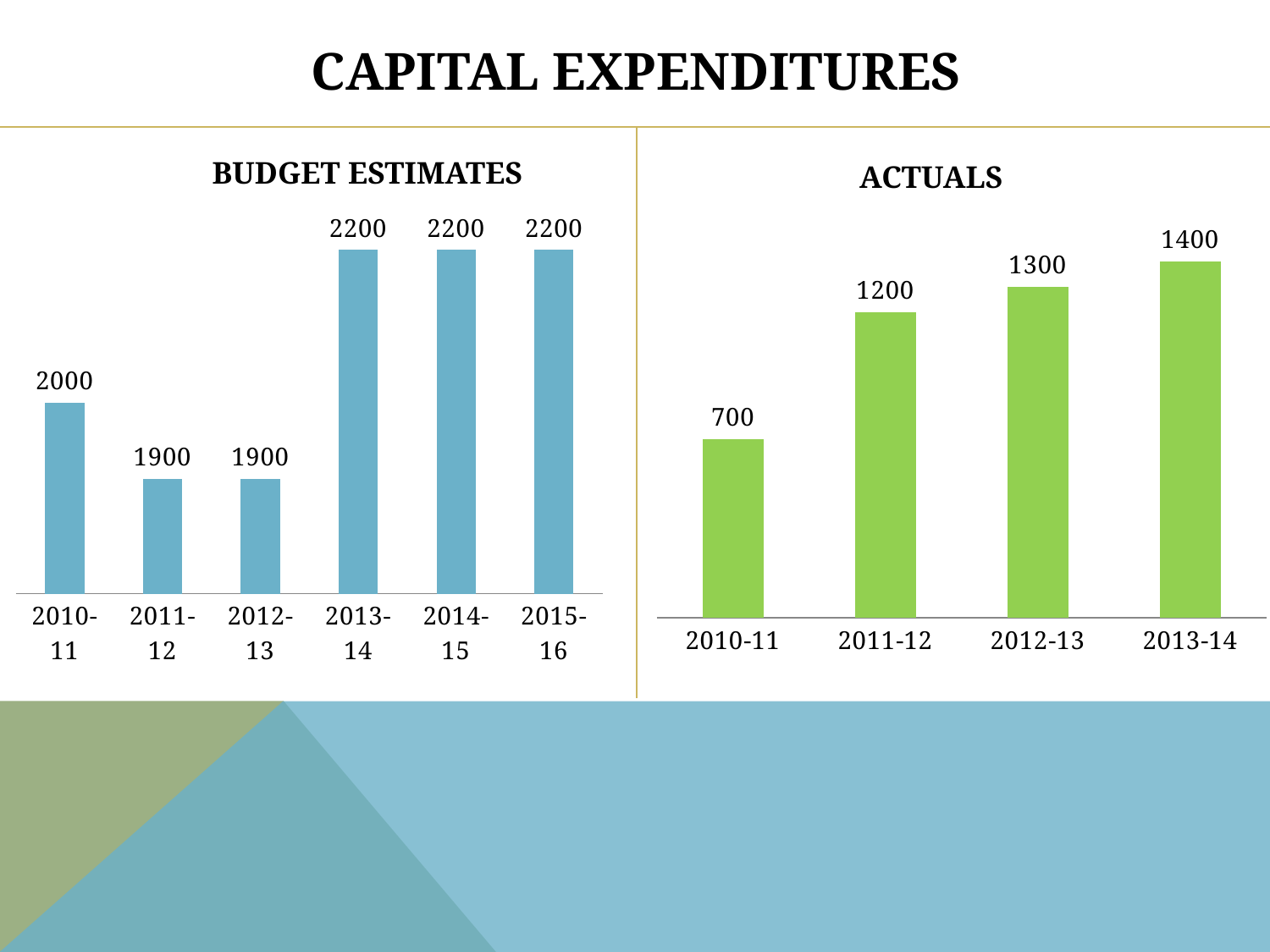
In the Actuals chart, what is the value for 2011-12? 1200 How many years are shown in the Budget Estimates chart? 6 In the Actuals chart, which year has the lowest value? 2010-11 How many years are shown in the Actuals chart? 4 In the Budget Estimates chart, what is the value for 2010-11? 2000 In the Actuals chart, what is the difference between the values for 2013-14 and 2010-11? 700 What kind of chart is the Actuals chart? bar chart In the Actuals chart, do the values rise or fall from 2010-11 to 2013-14? rise In the Actuals chart, which year has the highest value? 2013-14 In the Budget Estimates chart, which is larger, the value for 2010-11 or the value for 2011-12? 2010-11 In the Budget Estimates chart, what is the difference between the values for 2013-14 and 2011-12? 300 In the Budget Estimates chart, what is the value for 2012-13? 1900